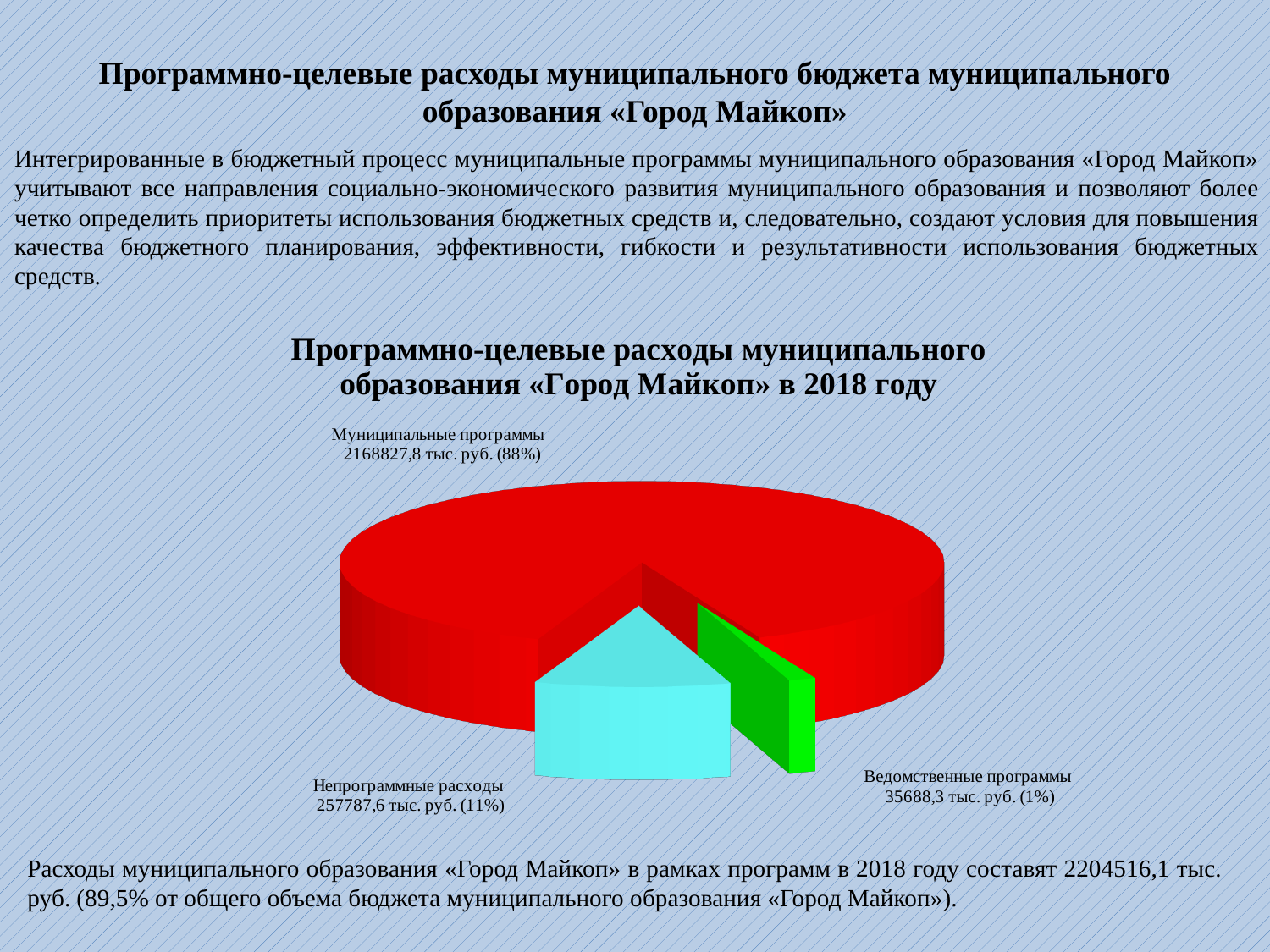
What share of the pie does Муниципальные программы represent? 88% What type of chart is shown on the slide? Pie chart Which category has the smallest slice? Ведомственные программы Which is larger, Непрограммные расходы or Ведомственные программы? Непрограммные расходы How many slices does the pie chart have? 3 What share of the pie does Ведомственные программы represent? 1% What is the value for Муниципальные программы? 2168827,8 тыс. руб. What share of the pie does Непрограммные расходы represent? 11% What is the value for Ведомственные программы? 35688,3 тыс. руб. What is the value for Непрограммные расходы? 257787,6 тыс. руб. Which category has the largest slice? Муниципальные программы What is the title of the chart? Программно-целевые расходы муниципального образования «Город Майкоп» в 2018 году